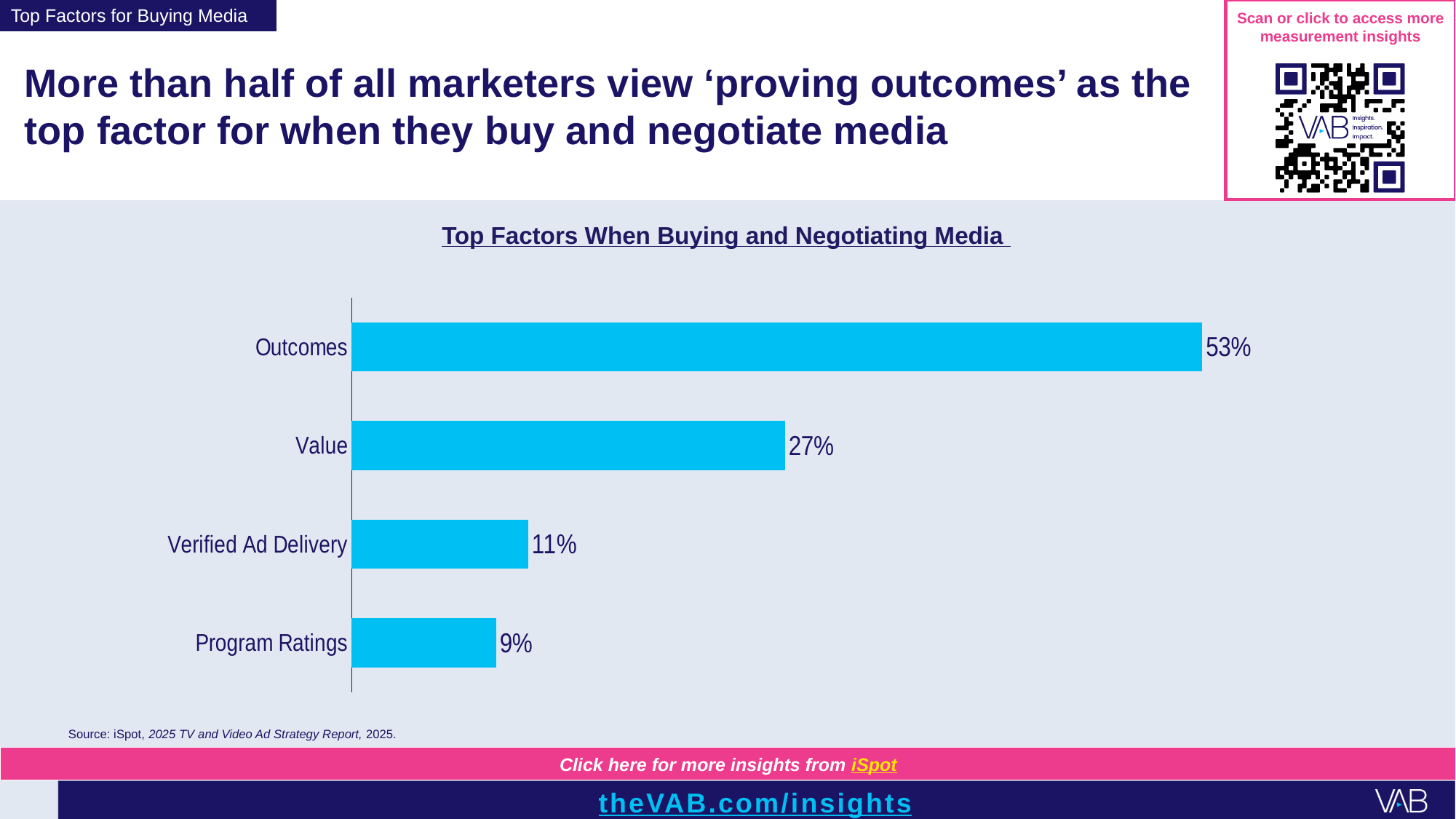
What percentage of marketers cite Outcomes as a top factor when buying and negotiating media? 53% What is the title of the chart? Top Factors When Buying and Negotiating Media Which has a larger value, Value or Verified Ad Delivery? Value What percentage is shown for Verified Ad Delivery? 11% What is the value shown for Value in the chart? 27% What percentage is shown for Program Ratings? 9% What is the difference in percentage points between Verified Ad Delivery and Program Ratings? 2 What is the difference in percentage points between Outcomes and Value? 26 How many factors are shown in the chart? 4 What type of chart is used on this slide? Bar chart Which factor has the lowest percentage in the chart? Program Ratings Which factor has the highest percentage in the chart? Outcomes